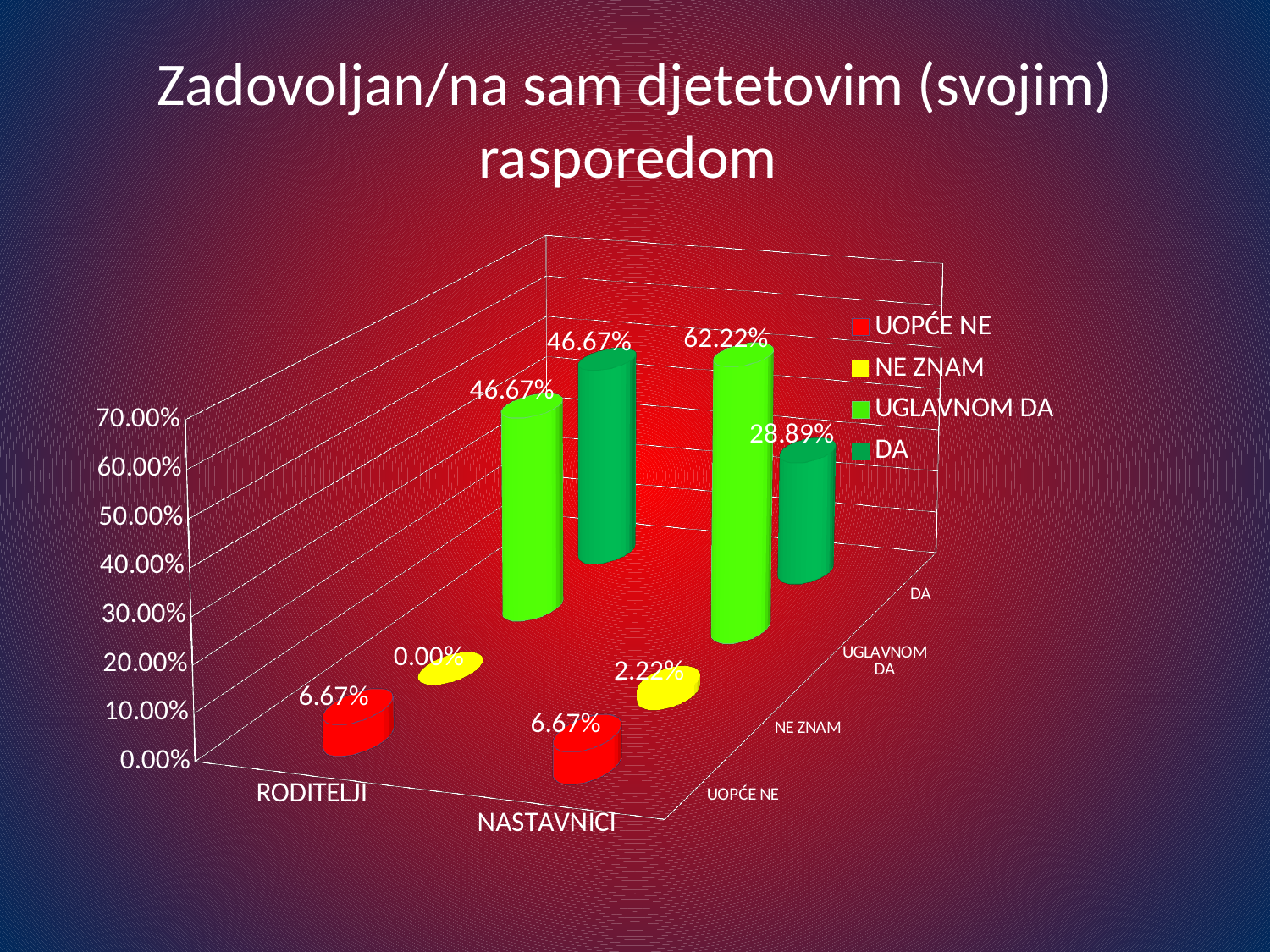
What is the value for NE ZNAM for RODITELJI? 0.00% How many series does the legend list? 4 What is the value for UOPĆE NE for NASTAVNICI? 6.67% What is the difference between the UGLAVNOM DA values for NASTAVNICI and RODITELJI? 15.55% Which is larger: the DA value for RODITELJI or the DA value for NASTAVNICI? RODITELJI What is the value for DA for RODITELJI? 46.67% Which series has the lowest value for RODITELJI? NE ZNAM How many categories are shown on the x axis? 2 What is the value for DA for NASTAVNICI? 28.89% What is the value for UGLAVNOM DA for NASTAVNICI? 62.22% What kind of chart is shown on the slide? bar chart Which series has the highest value for NASTAVNICI? UGLAVNOM DA